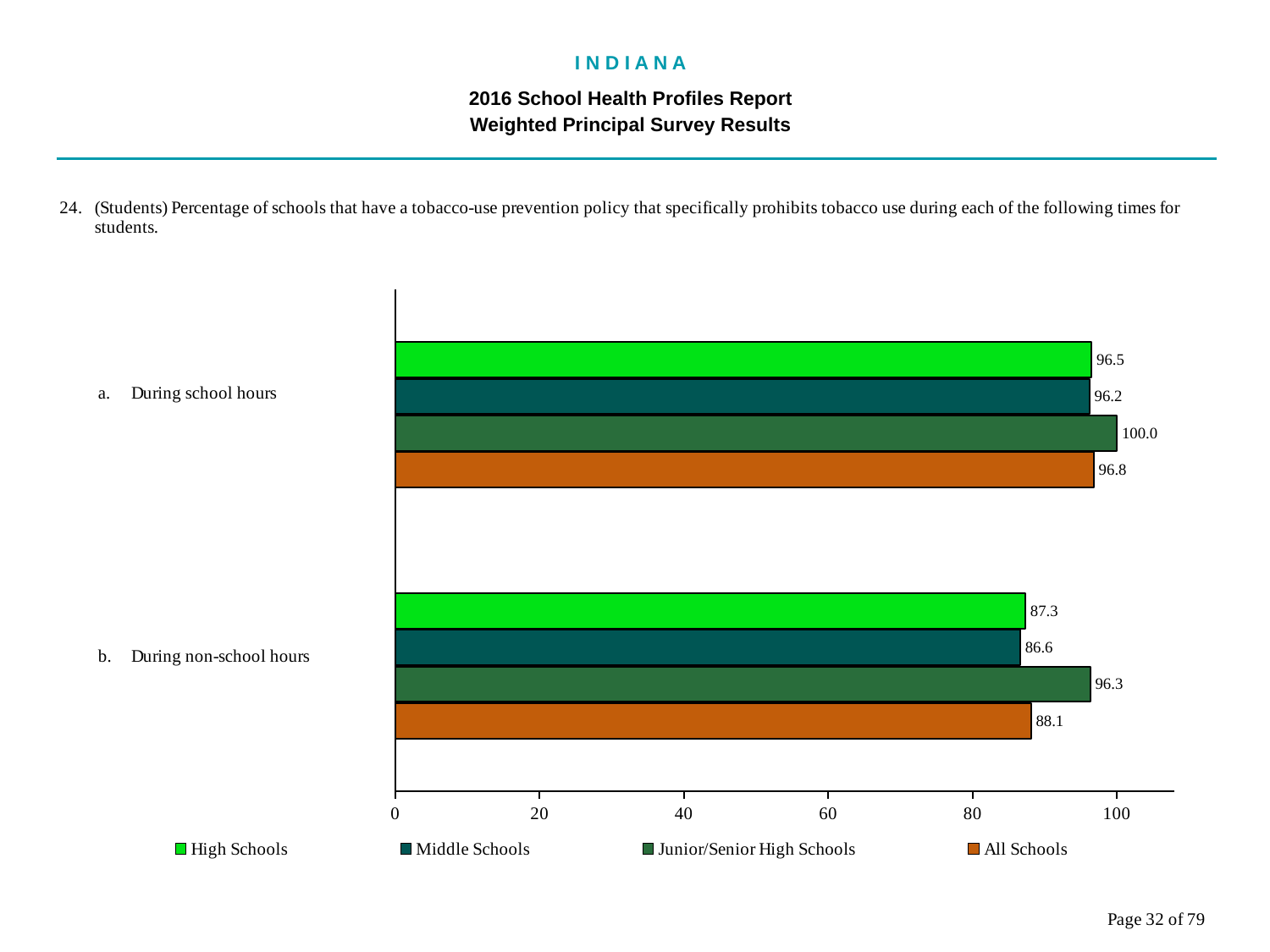
What kind of chart is shown on the slide? Bar chart How many series does the legend list? 4 Which school type has the lowest value during non-school hours? Middle Schools What is the value for All Schools during non-school hours? 88.1 What colour represents All Schools in the legend? Orange What is the value for Middle Schools during non-school hours? 86.6 What is the difference between the Junior/Senior High Schools value and the Middle Schools value during non-school hours? 9.7 What is the value for Junior/Senior High Schools during school hours? 100.0 Which school type has the highest value during non-school hours? Junior/Senior High Schools Is the value for All Schools during non-school hours greater or less than 80? greater What is the value for High Schools during school hours? 96.5 Which is larger for High Schools: the value during school hours or during non-school hours? During school hours